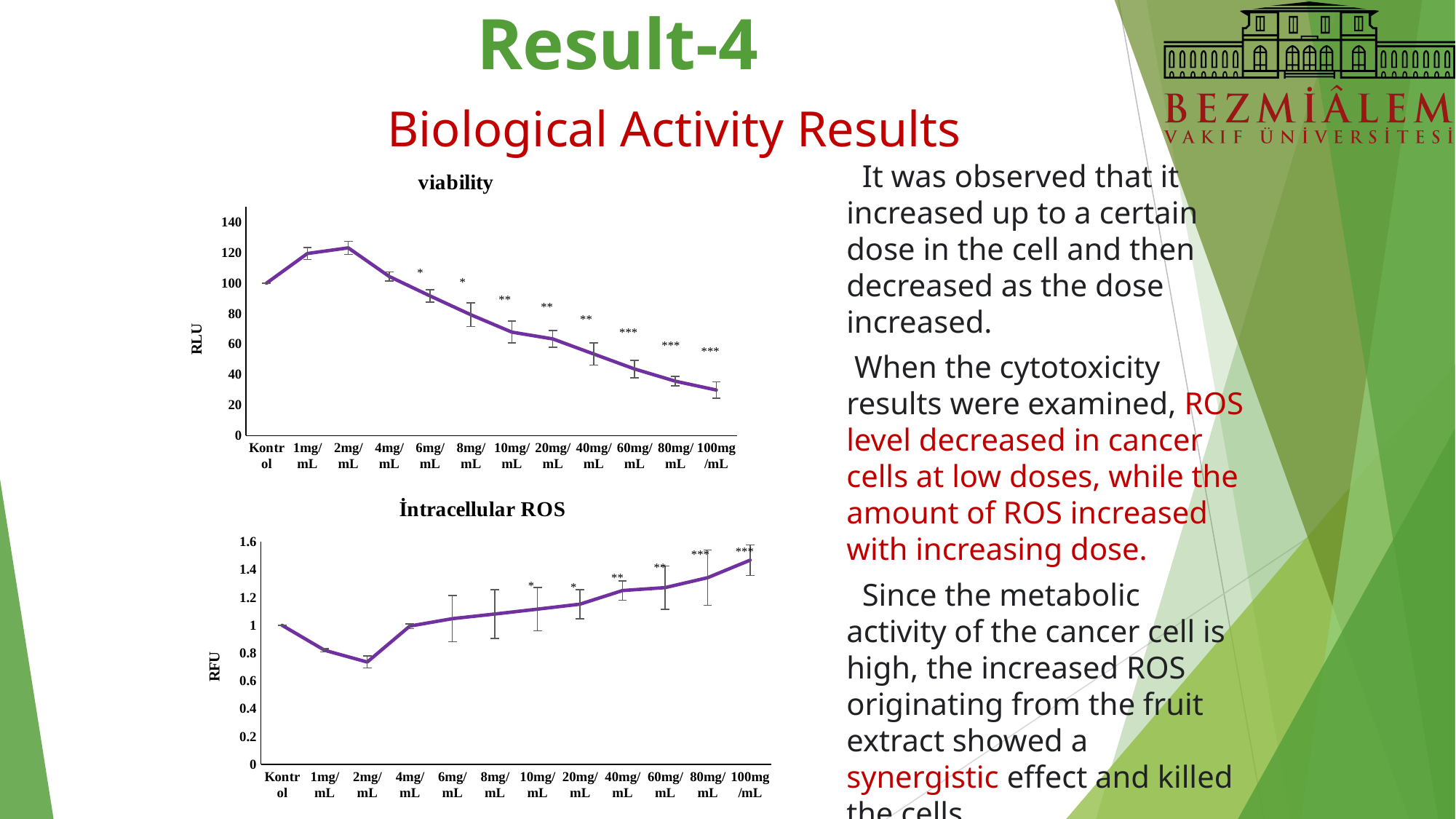
In the "viability" chart, which dose has the highest RLU value? 2mg/mL In the "İntracellular ROS" chart, which dose has the lowest RFU value? 2mg/mL In the "İntracellular ROS" chart, what is the RFU value for Kontrol? 1 In the "viability" chart, which is larger, the value for Kontrol or the value for 100mg/mL? Kontrol In the "İntracellular ROS" chart, is the value for 100mg/mL greater or less than 1.2? greater How many dose categories are shown on the x axis of the "İntracellular ROS" chart? 12 What type of chart is the "viability" chart? line chart In the "viability" chart, do the values rise or fall from 2mg/mL to 100mg/mL? fall In the "viability" chart, is the value for 100mg/mL greater or less than 40? less In the "İntracellular ROS" chart, which dose has the highest RFU value? 100mg/mL In the "viability" chart, which dose has the lowest RLU value? 100mg/mL In the "viability" chart, what is the RLU value for Kontrol? 100